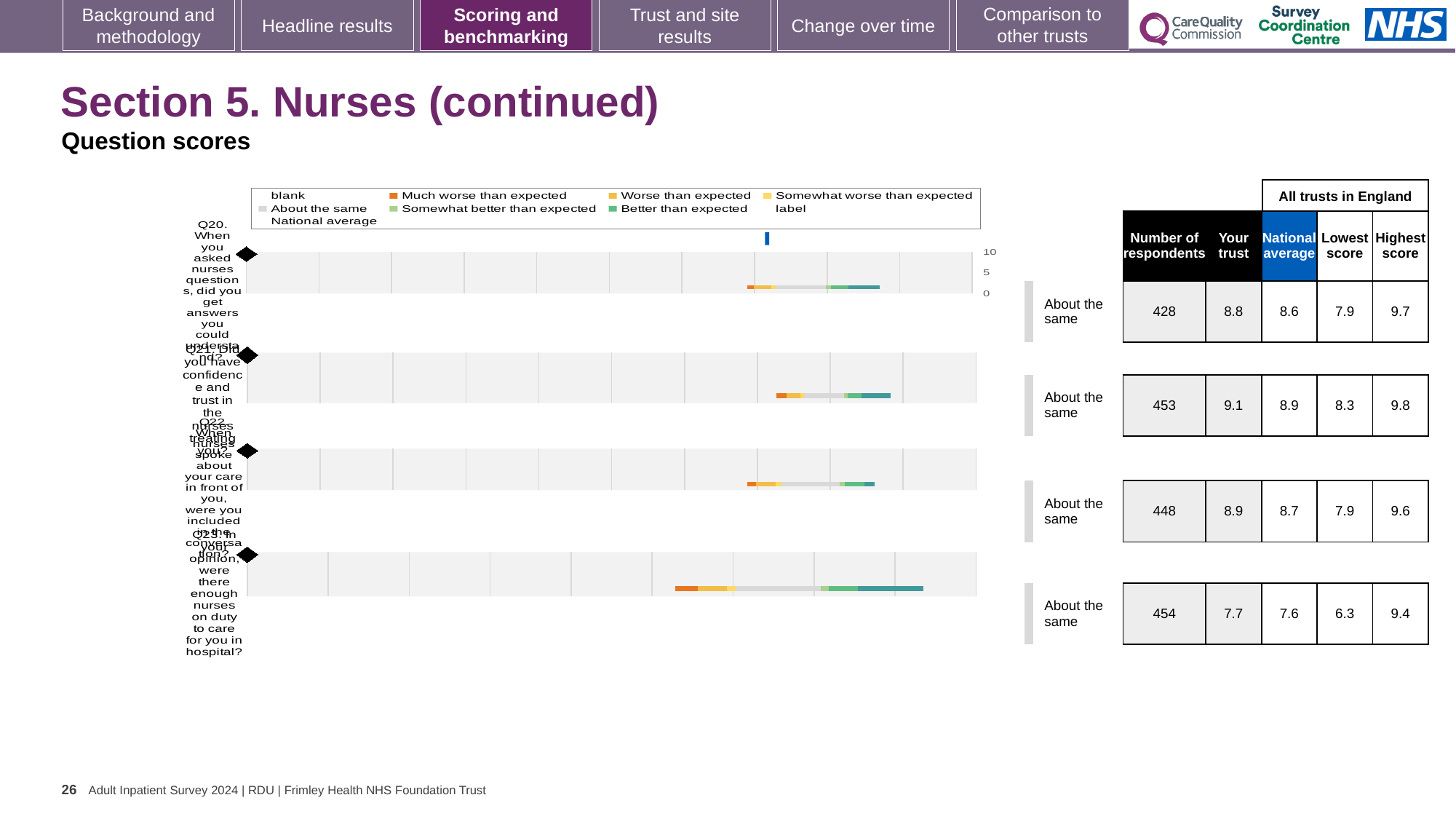
What is the national average score for Q23 (enough nurses on duty)? 7.6 How many questions (Q20 to Q23) are plotted in the chart? 4 What is the 'Your trust' score for Q21 (confidence and trust in the nurses)? 9.1 For Q20, what is the difference between the 'Your trust' score and the national average? 0.2 What benchmark category is shown for all four questions on this slide? About the same For Q22, which is larger: the 'Your trust' score or the national average? Your trust Which question has the highest 'Your trust' score? Q21 How many respondents answered Q23? 454 What is the highest score among all trusts in England for Q21? 9.8 What kind of chart is used to show the question scores on this slide? Bar chart Is the 'Your trust' score for Q23 greater or less than 5 on the chart axis? greater Which question has the lowest 'Your trust' score? Q23